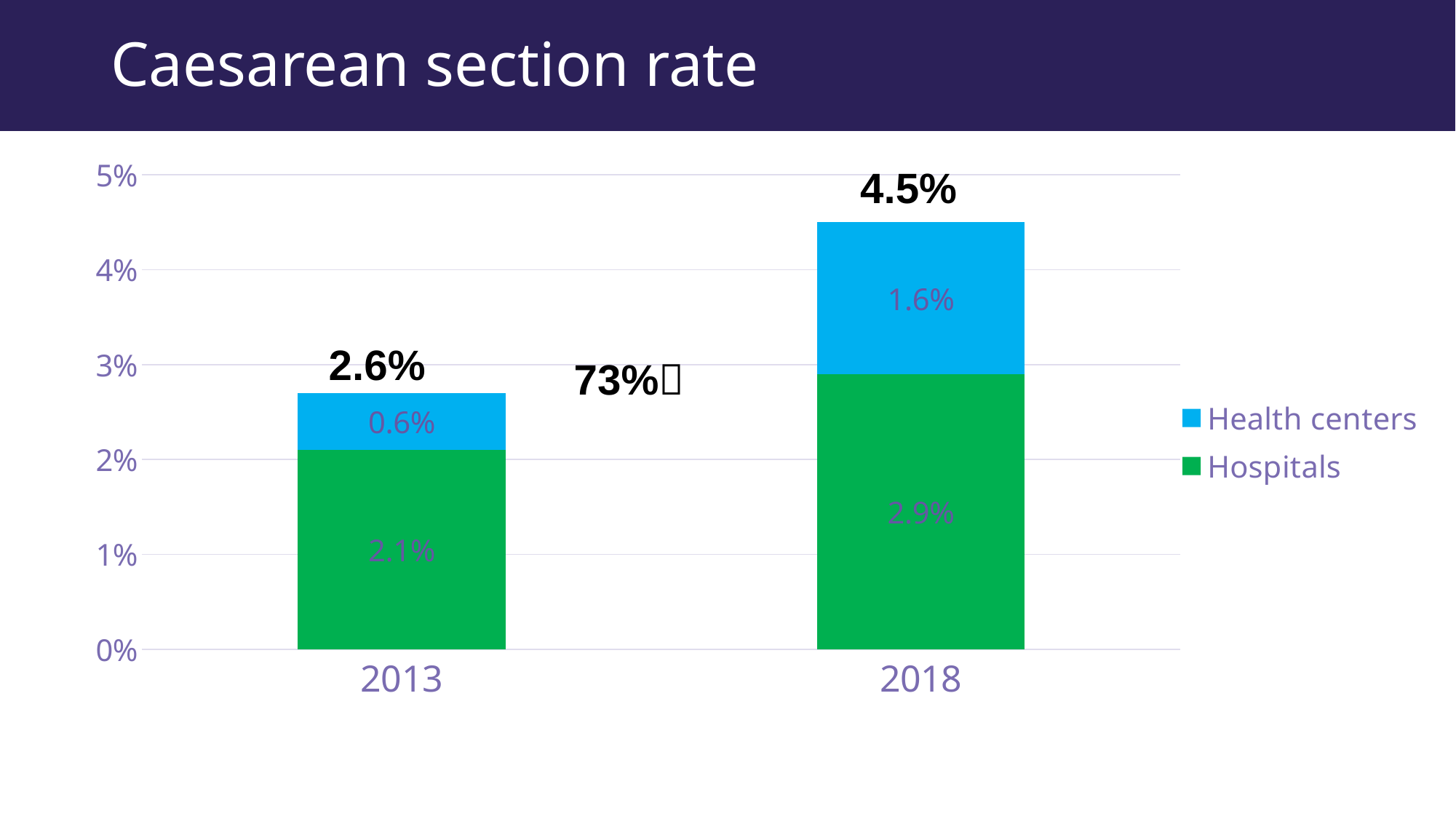
What is the Hospitals value for 2013? 2.1% What kind of chart is shown on the slide? Stacked bar chart How many series does the legend list? 2 What is the title of the chart? Caesarean section rate What is the total of the stacked bar for 2018? 4.5% What is the total of the stacked bar for 2013? 2.6% What is the Health centers value for 2018? 1.6% Which year has the higher total caesarean section rate? 2018 What is the Health centers value for 2013? 0.6% Is the Health centers value for 2018 larger than the Health centers value for 2013? Yes What is the Hospitals value for 2018? 2.9% What is the difference between the Hospitals values for 2018 and 2013? 0.8%